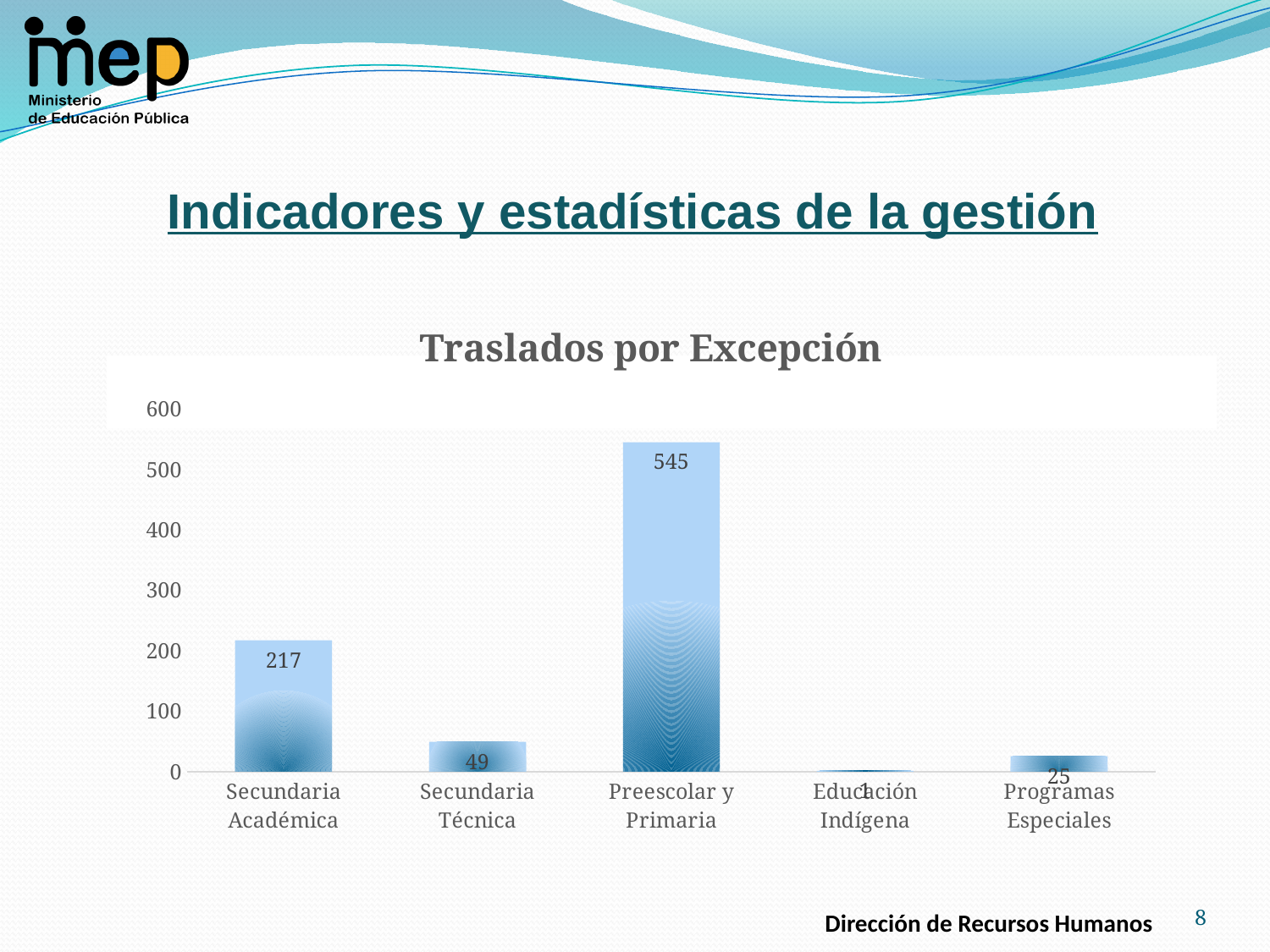
Is the value for Secundaria Académica greater or less than 300? less What is the difference between the values for Preescolar y Primaria and Secundaria Académica? 328 How many categories are shown in the chart? 5 Which is larger, the value for Secundaria Técnica or the value for Programas Especiales? Secundaria Técnica What is the value for Programas Especiales? 25 What is the value for Secundaria Académica? 217 Which category has the highest value? Preescolar y Primaria What type of chart is shown on the slide? bar chart What is the title of the chart? Traslados por Excepción What is the value for Preescolar y Primaria? 545 Which category has the lowest value? Educación Indígena What is the value for Secundaria Técnica? 49